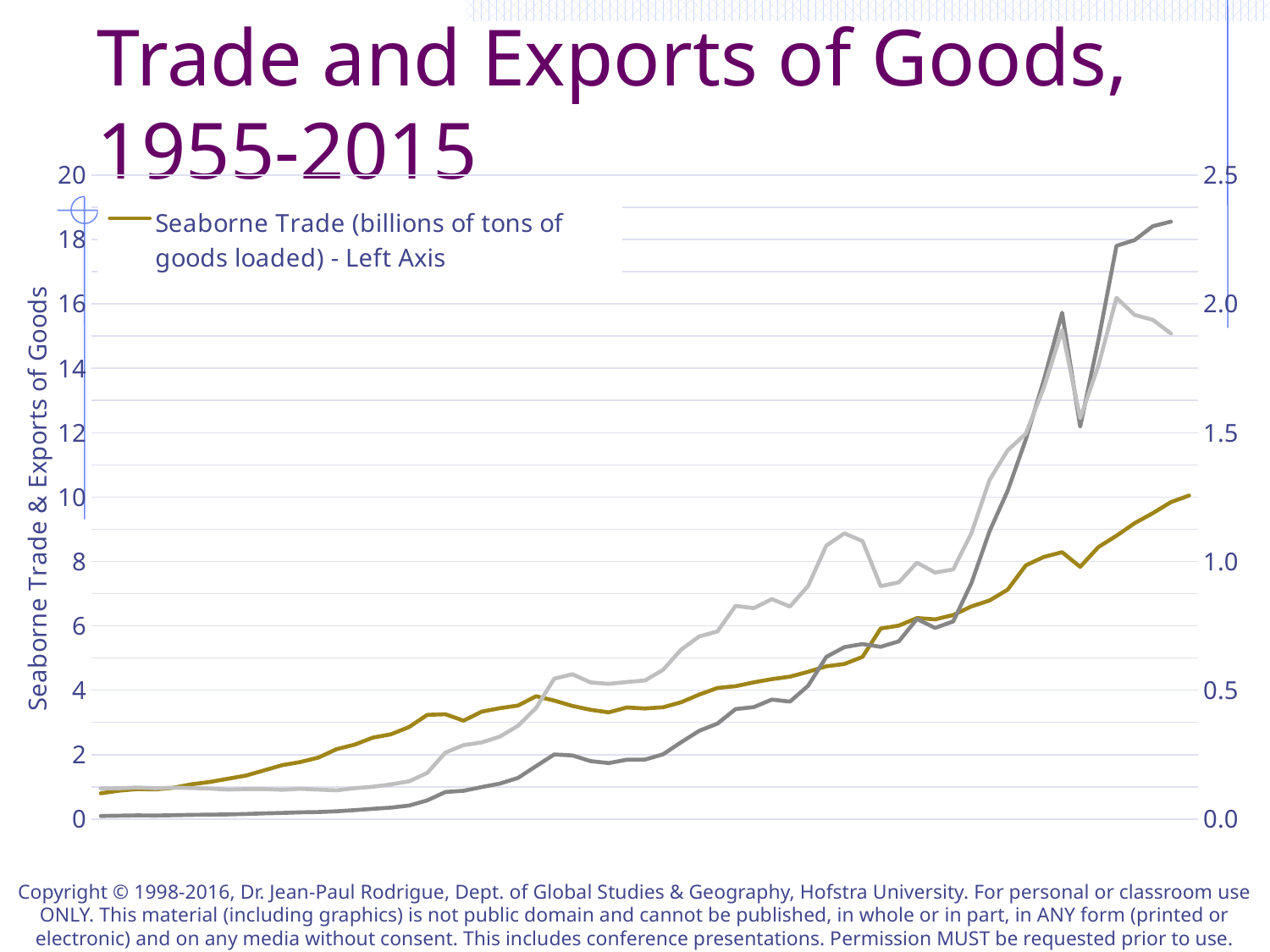
Is the Seaborne Trade value at the leftmost point of the chart greater or less than 2? less How many lines are plotted on the chart? 3 Is the Seaborne Trade value at the rightmost point of the chart greater or less than 8? greater Is the highest value reached by the Seaborne Trade line greater or less than 12? less What kind of chart is shown on the slide? line chart What is the title of the chart on the slide? Trade and Exports of Goods, 1955-2015 On which axis is the Seaborne Trade series plotted? Left Axis Does the Seaborne Trade line rise or fall from left to right across the chart? rise